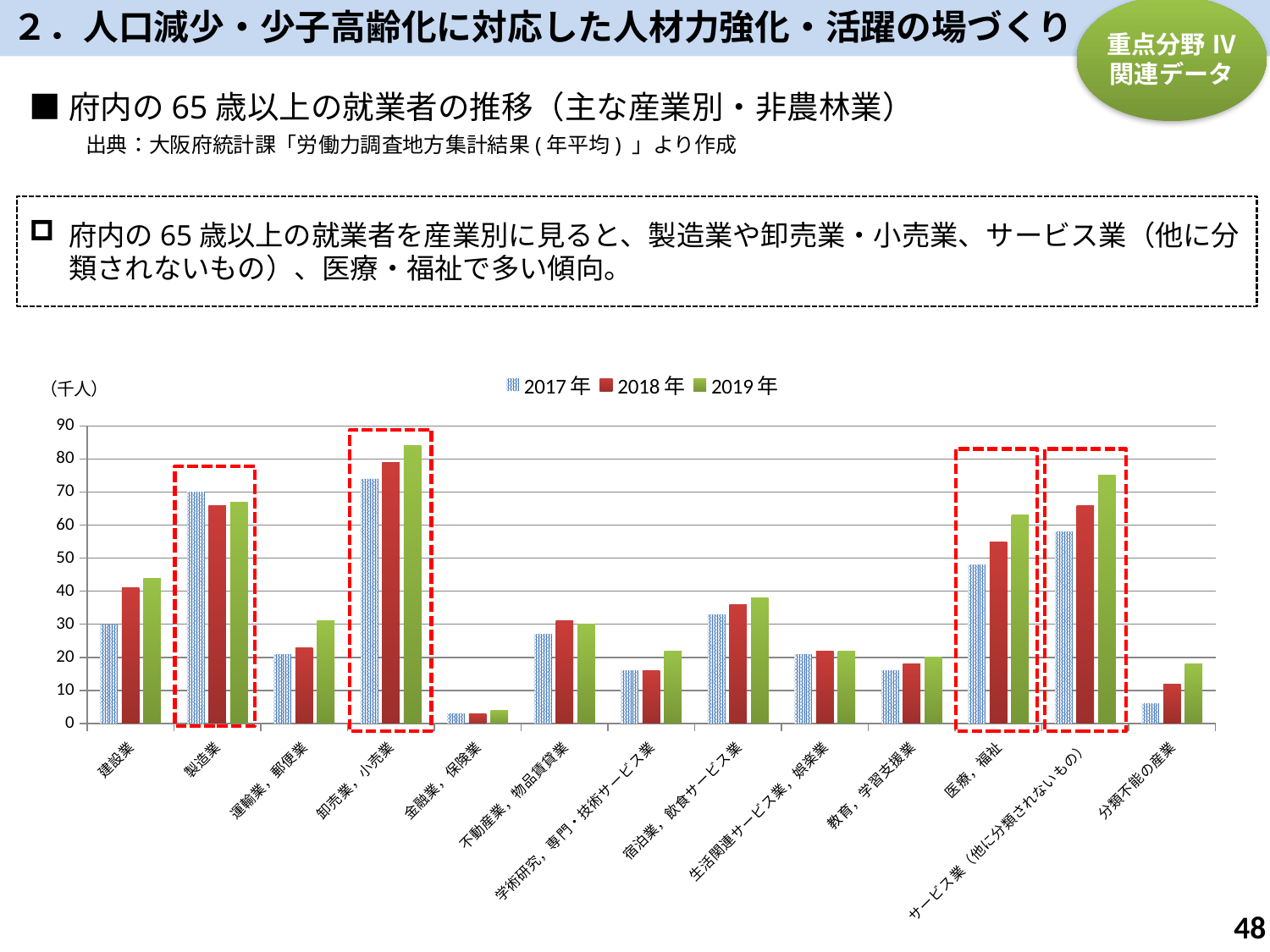
Which industry has the highest bar in the chart? 卸売業，小売業 How many industry categories are shown on the x axis? 13 How many series does the legend list? 3 What kind of chart is shown on the slide? bar chart Which is larger in 2019年: 医療，福祉 or サービス業（他に分類されないもの）? サービス業（他に分類されないもの） Do the values for 医療，福祉 rise or fall from 2017年 to 2019年? rise Is the 2019年 value for サービス業（他に分類されないもの） greater or less than 70? greater What unit is shown for the vertical axis? 千人 Which industry has the lowest bars in the chart? 金融業，保険業 Is the 2019年 value for 卸売業，小売業 greater or less than 80? greater Which years are listed in the legend? 2017年, 2018年, 2019年 Is the 2017年 value for 分類不能の産業 greater or less than 10? less